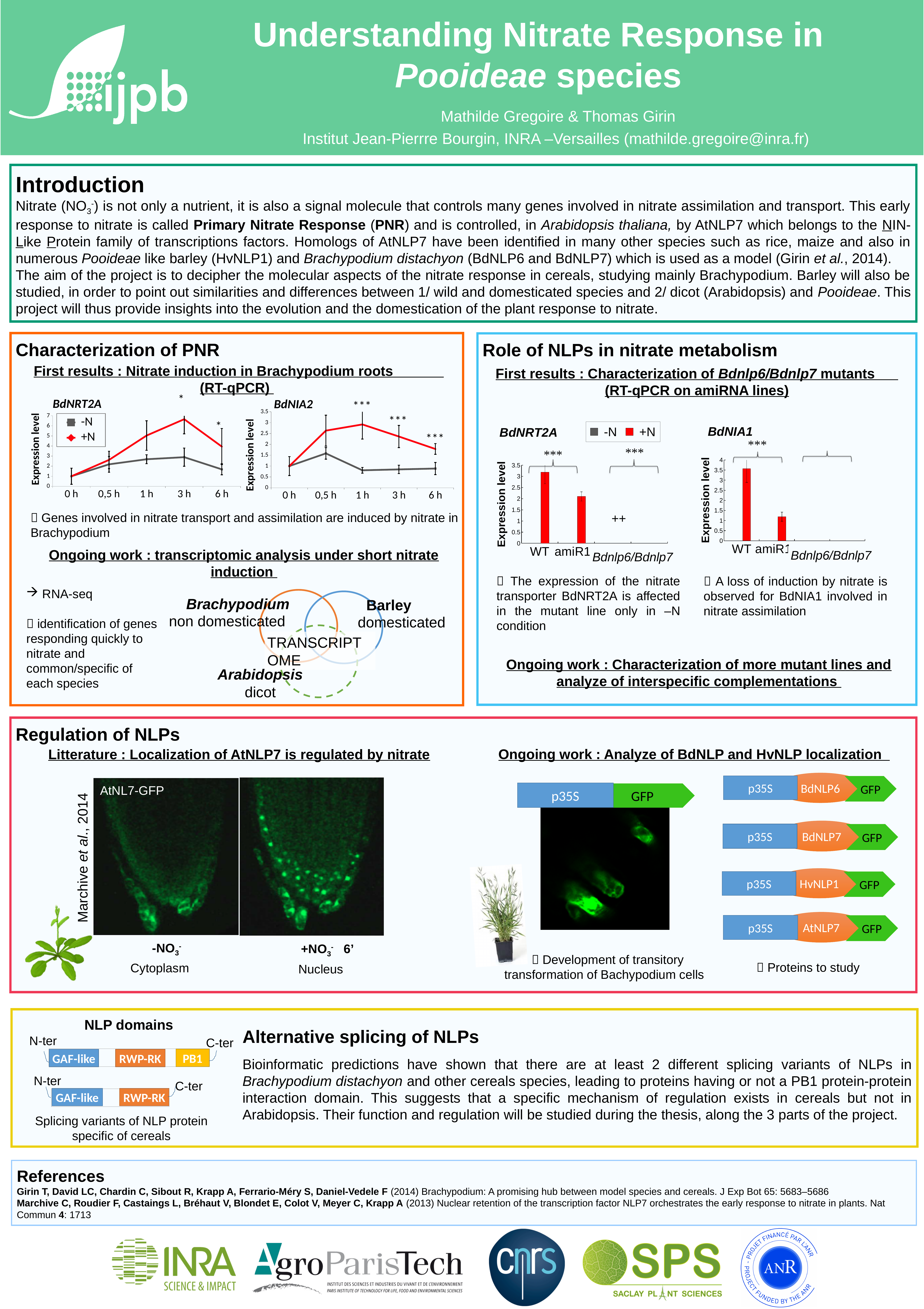
In the BdNIA1 bar chart under 'Role of NLPs in nitrate metabolism', is the WT bar greater or less than 3? greater In the BdNIA1 chart under 'Role of NLPs in nitrate metabolism', what kind of chart is it? bar chart In the BdNRT2A chart under 'Characterization of PNR', how many series does the legend list? 2 In the BdNRT2A chart under 'Characterization of PNR', is the +N value at 3 h greater or less than 6? greater In the BdNRT2A chart under 'Characterization of PNR', at which time point does the +N series reach its highest expression level? 3 h In the BdNRT2A bar chart under 'Role of NLPs in nitrate metabolism', which has the taller bar, WT or amiR1? WT In the BdNRT2A chart under 'Characterization of PNR', which series has the larger value at 3 h, -N or +N? +N In the BdNIA1 bar chart under 'Role of NLPs in nitrate metabolism', is the amiR1 bar greater or less than 2? less In the BdNIA2 chart under 'Characterization of PNR', how many time points are shown on the x axis? 5 In the BdNIA2 chart under 'Characterization of PNR', at which time point does the +N series reach its highest expression level? 1 h In the BdNRT2A chart under 'Characterization of PNR', what kind of chart is it? line chart